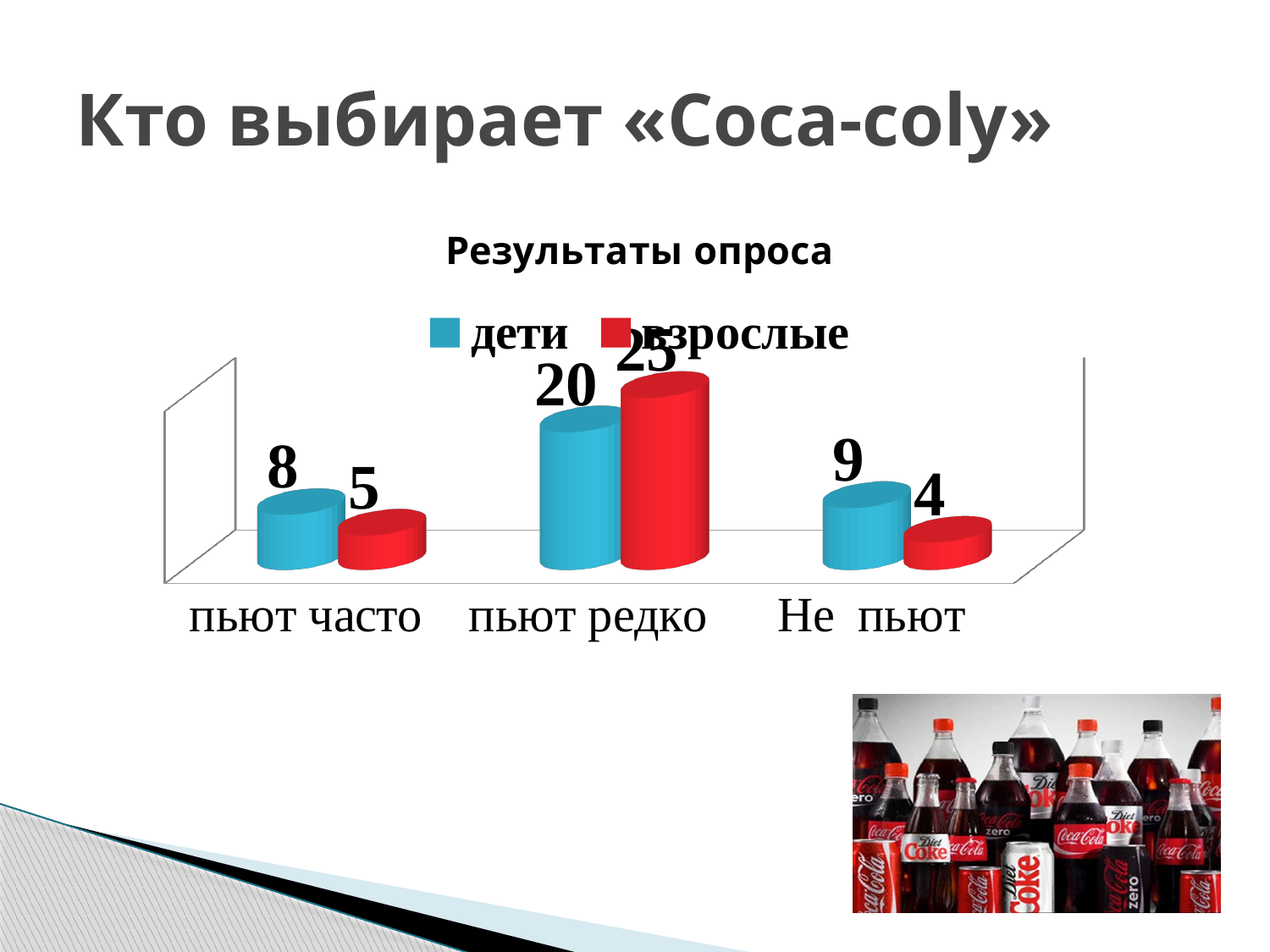
What is the value for дети in the пьют часто category? 8 What is the value for взрослые in the Не пьют category? 4 Which category has the lowest value for взрослые? Не пьют What is the title of the chart? Результаты опроса How many categories are shown on the x axis? 3 What is the value for дети in the Не пьют category? 9 What kind of chart is shown on the slide? bar chart In the Не пьют category, which series has the larger value, дети or взрослые? дети What is the difference between дети and взрослые in the пьют редко category? 5 How many series does the legend list? 2 Which category has the highest value for дети? пьют редко What is the value for взрослые in the пьют редко category? 25